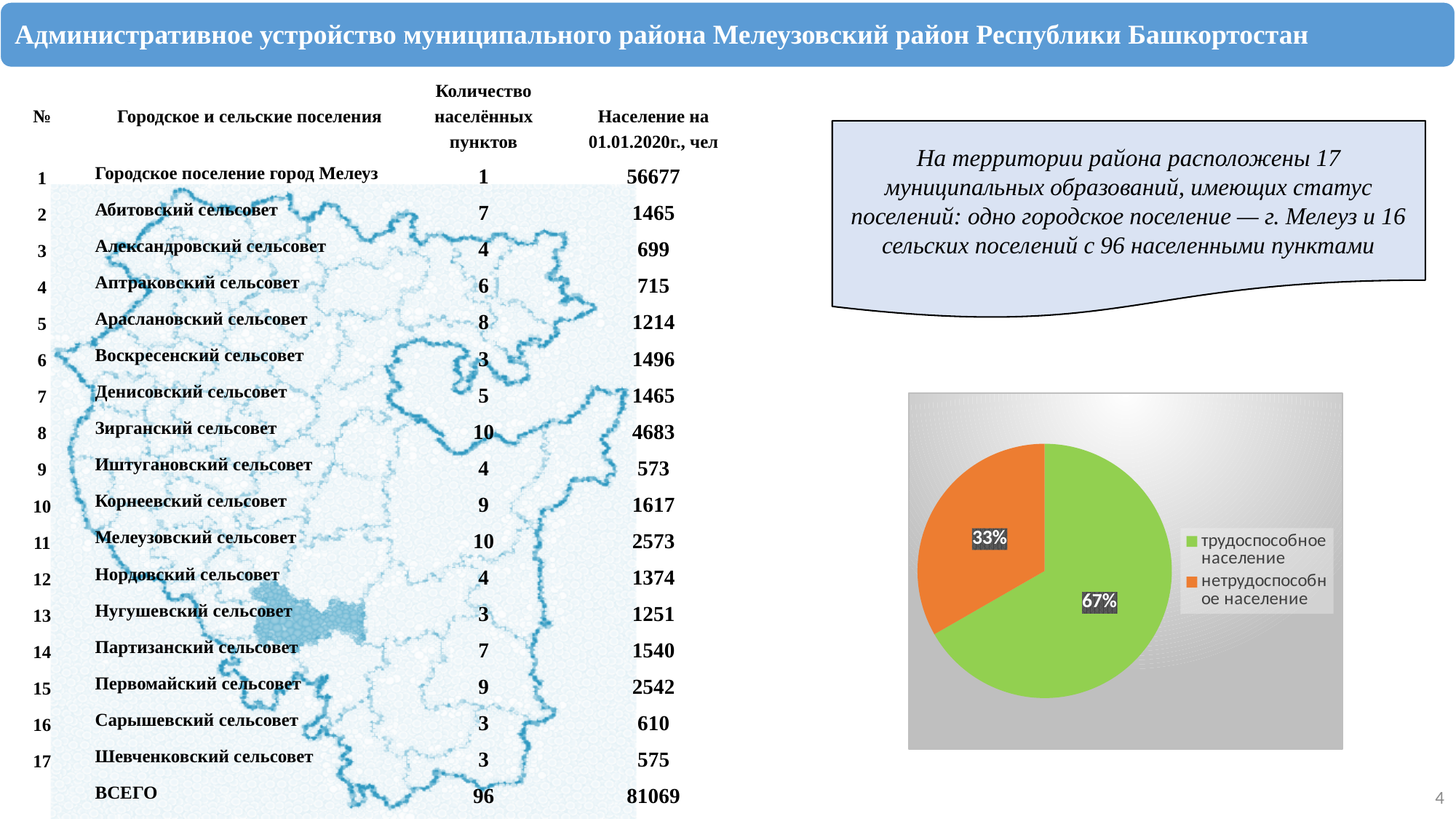
By how many percentage points does трудоспособное население exceed нетрудоспособное население in the pie chart? 34 In the pie chart, which is larger: трудоспособное население or нетрудоспособное население? трудоспособное население What share of the pie chart is labelled "нетрудоспособное население"? 33% How many slices does the pie chart have? 2 What colour is the slice for трудоспособное население in the pie chart? green What kind of chart is shown on the right side of the slide? pie chart Which slice of the pie chart is the largest? трудоспособное население Which slice of the pie chart is the smallest? нетрудоспособное население What colour is the slice for нетрудоспособное население in the pie chart? orange How many entries does the legend of the pie chart list? 2 What share of the pie chart is labelled "трудоспособное население"? 67%